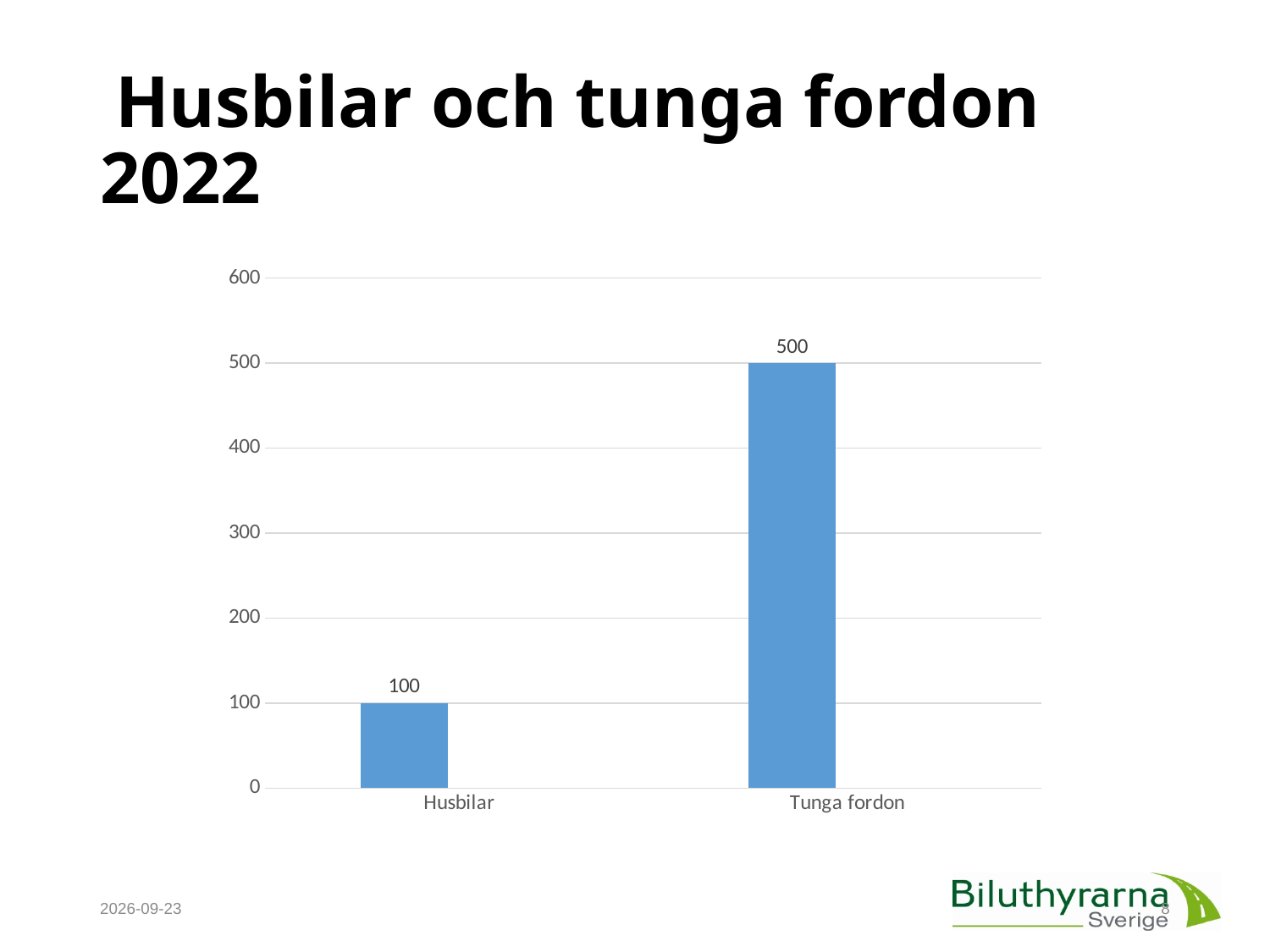
Which category has the highest value? Tunga fordon Is the value for Husbilar greater or less than 200? less What is the highest value shown on the y axis? 600 What is the value for Husbilar? 100 What kind of chart is shown on the slide? bar chart What is the difference between the values for Tunga fordon and Husbilar? 400 Which is larger, the value for Husbilar or the value for Tunga fordon? Tunga fordon What is the value for Tunga fordon? 500 Is the value for Tunga fordon greater or less than 400? greater Which category has the lowest value? Husbilar What is the title of the slide? Husbilar och tunga fordon 2022 How many categories are shown on the x axis? 2